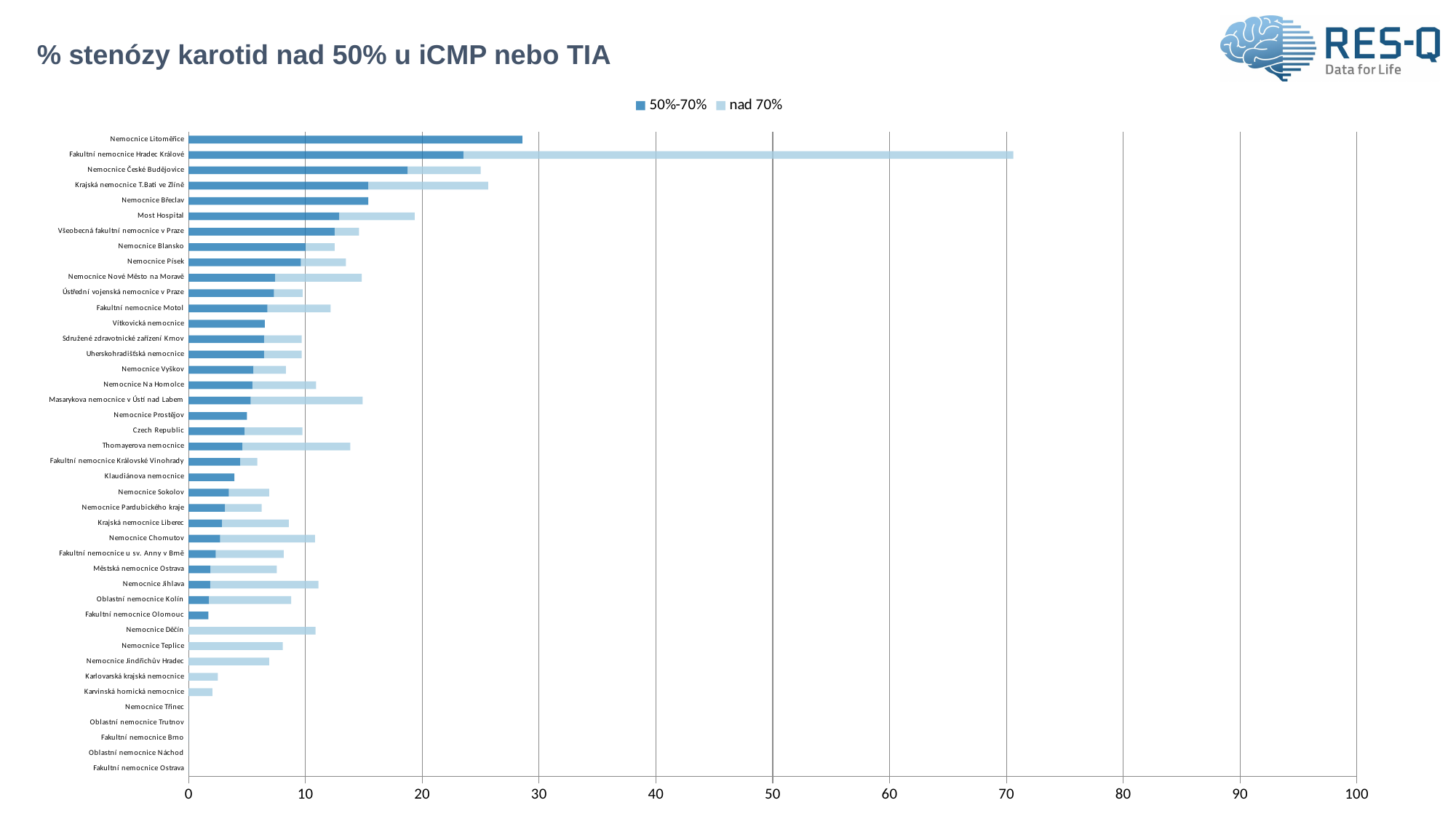
Which is larger for the '50%-70%' series: Nemocnice Litoměřice or Fakultní nemocnice Hradec Králové? Nemocnice Litoměřice How many hospitals/categories are listed on the vertical axis? 42 Is the 'nad 70%' value for Fakultní nemocnice Hradec Králové greater or less than 60? less How many series does the legend list? 2 Which category has the highest value for the '50%-70%' series? Nemocnice Litoměřice What is the title of the chart? % stenózy karotid nad 50% u iCMP nebo TIA Is the '50%-70%' value for Nemocnice Litoměřice greater or less than 20? greater What kind of chart is shown on the slide? bar chart What are the two series named in the legend? 50%-70% and nad 70% Is the 'nad 70%' value for Nemocnice Děčín greater or less than 20? less Which category has the highest value for the 'nad 70%' series? Fakultní nemocnice Hradec Králové Which is larger for the 'nad 70%' series: Masarykova nemocnice v Ústí nad Labem or Nemocnice Vyškov? Masarykova nemocnice v Ústí nad Labem